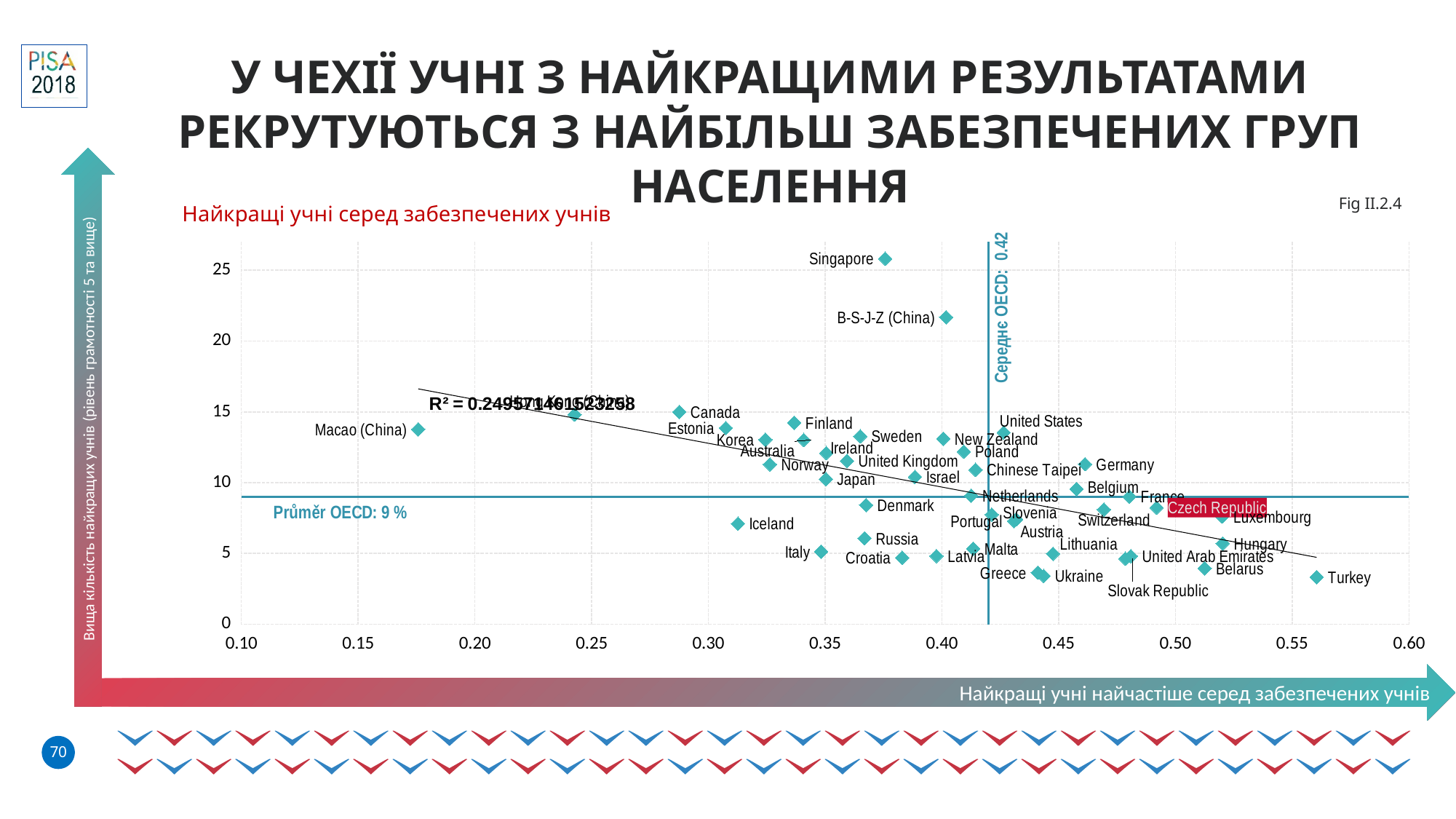
Is the horizontal-axis value for Czech Republic greater or less than 0.45? greater What kind of chart is shown on the slide? scatter chart Which country is furthest to the right on the horizontal axis? Turkey Is the vertical-axis value for Singapore greater or less than 20? greater Is the vertical-axis value for Iceland greater or less than 10? less Which country is furthest to the left on the horizontal axis? Macao (China) What OECD average value is marked by the horizontal line on the chart? 9 % Which has the higher vertical-axis value, Singapore or B-S-J-Z (China)? Singapore What OECD average value is marked by the vertical line on the chart? 0.42 Which country has the highest value on the vertical axis? Singapore